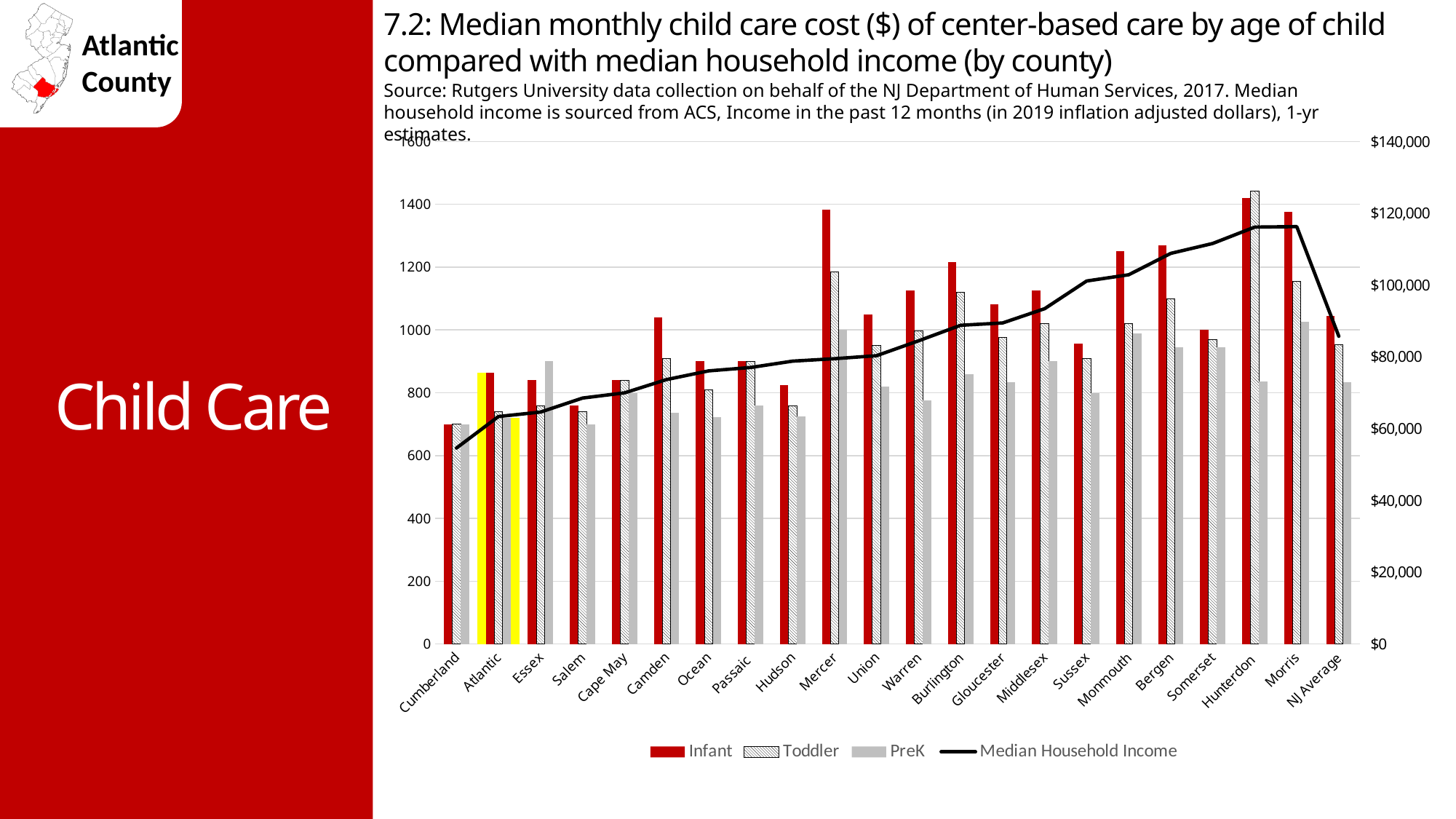
How many series does the legend list? 4 Is the Median Household Income for Cumberland greater or less than $60,000? less Which is larger, the Infant value for Mercer or the Infant value for Camden? Mercer Which category has the highest Toddler bar? Hunterdon Which county's bars are highlighted in yellow? Atlantic What kind of chart is shown on the slide? Bar chart with a line series Is the Infant value for Mercer greater or less than 1200? greater Is the Infant value for Cumberland greater or less than 800? less Which category has the lowest Infant bar? Cumberland How many counties/categories are shown along the x axis? 22 Does the Median Household Income line generally rise or fall from Cumberland to Morris? rise